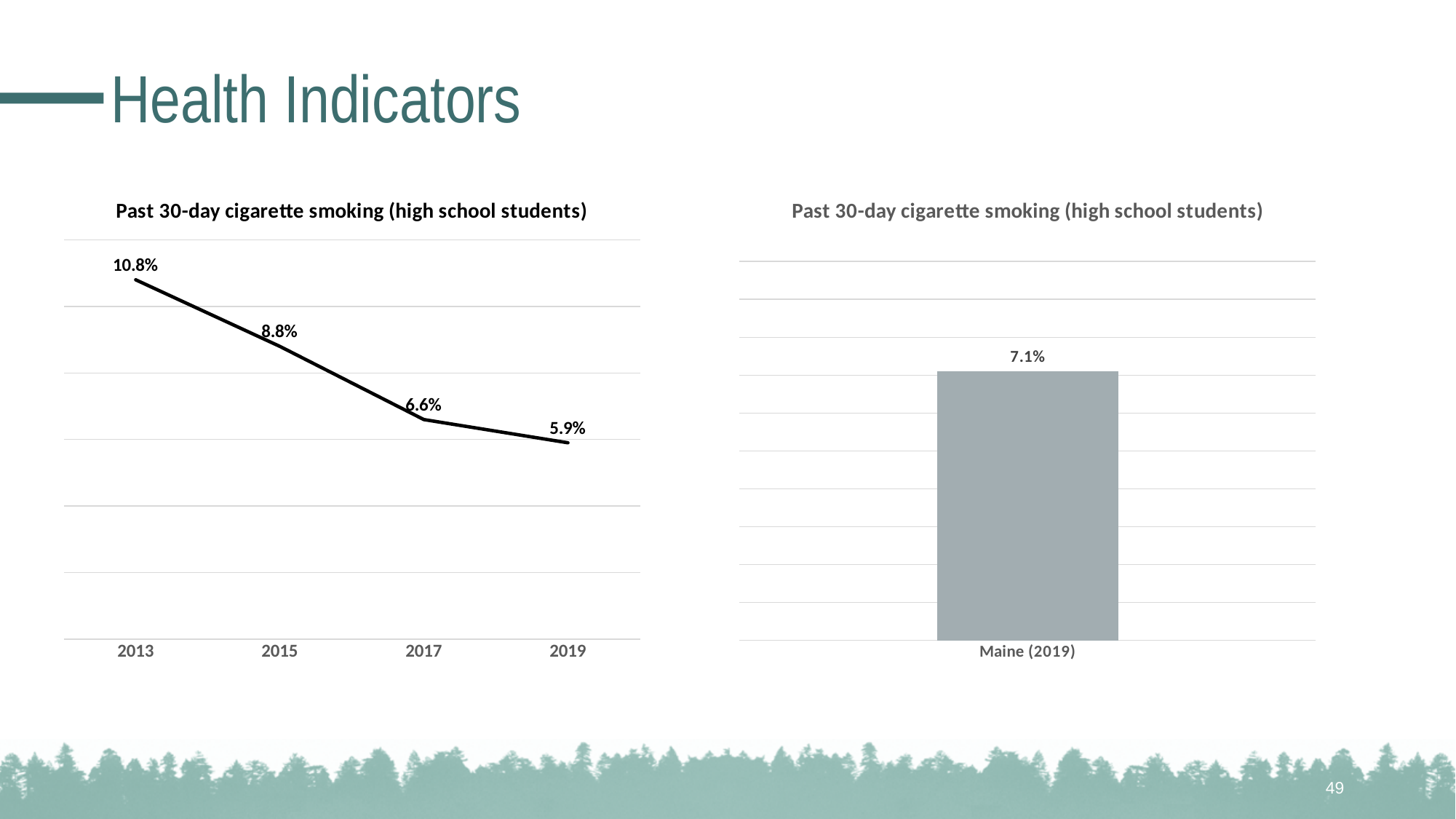
In the left chart (line chart), what is the value for 2017? 6.6% In the left chart (line chart), which year has the lowest value? 2019 In the left chart (line chart), what is the value for 2013? 10.8% In the right chart (bar chart), what is the value for Maine (2019)? 7.1% How many years are plotted in the left chart (line chart)? 4 What kind of chart is the right chart? bar chart In the left chart (line chart), which year has the highest value? 2013 In the left chart (line chart), what is the difference between the 2013 value and the 2019 value? 4.9% In the left chart (line chart), what is the value for 2019? 5.9% In the left chart (line chart), which is larger, the value for 2015 or the value for 2017? 2015 In the left chart (line chart), do the values rise or fall from 2013 to 2019? fall What is the title of the left chart? Past 30-day cigarette smoking (high school students)